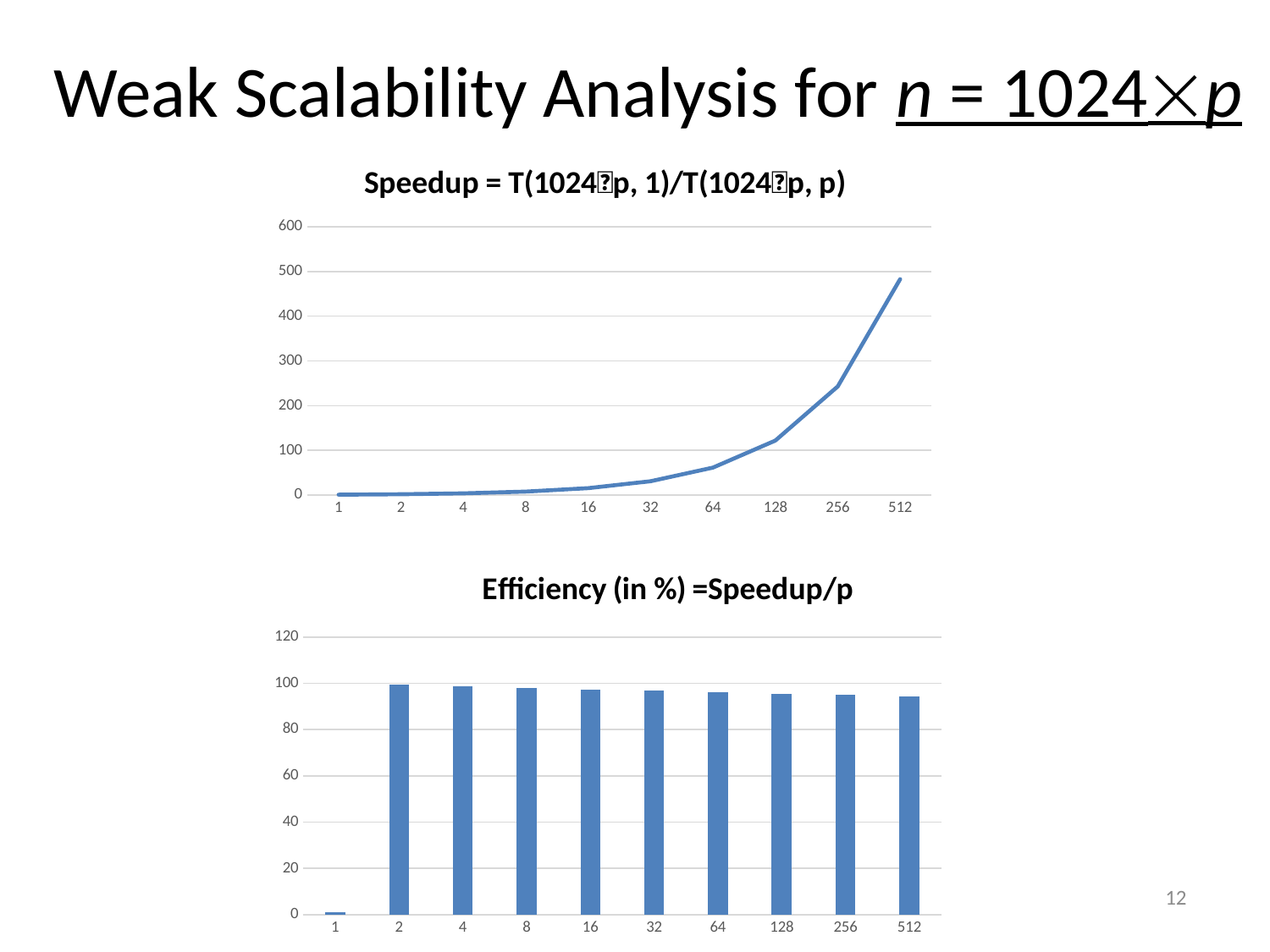
In the top Speedup chart, how many data points are plotted along the x axis? 10 In the top Speedup chart, is the value for 256 greater or less than 200? greater In the bottom Efficiency chart, is the value for 512 greater or less than 100? less In the top Speedup chart, which x-axis category has the highest speedup? 512 In the bottom Efficiency chart, which x-axis category has the lowest bar? 1 In the top Speedup chart, which x-axis category has the lowest speedup? 1 What type of chart is the bottom chart titled "Efficiency (in %) =Speedup/p"? bar chart What type of chart is the top chart titled "Speedup = T(1024·p, 1)/T(1024·p, p)"? line chart In the top Speedup chart, do the values rise or fall as p increases along the x axis? rise In the top Speedup chart, is the value for 512 greater or less than 400? greater In the bottom Efficiency chart, how many bars are there? 10